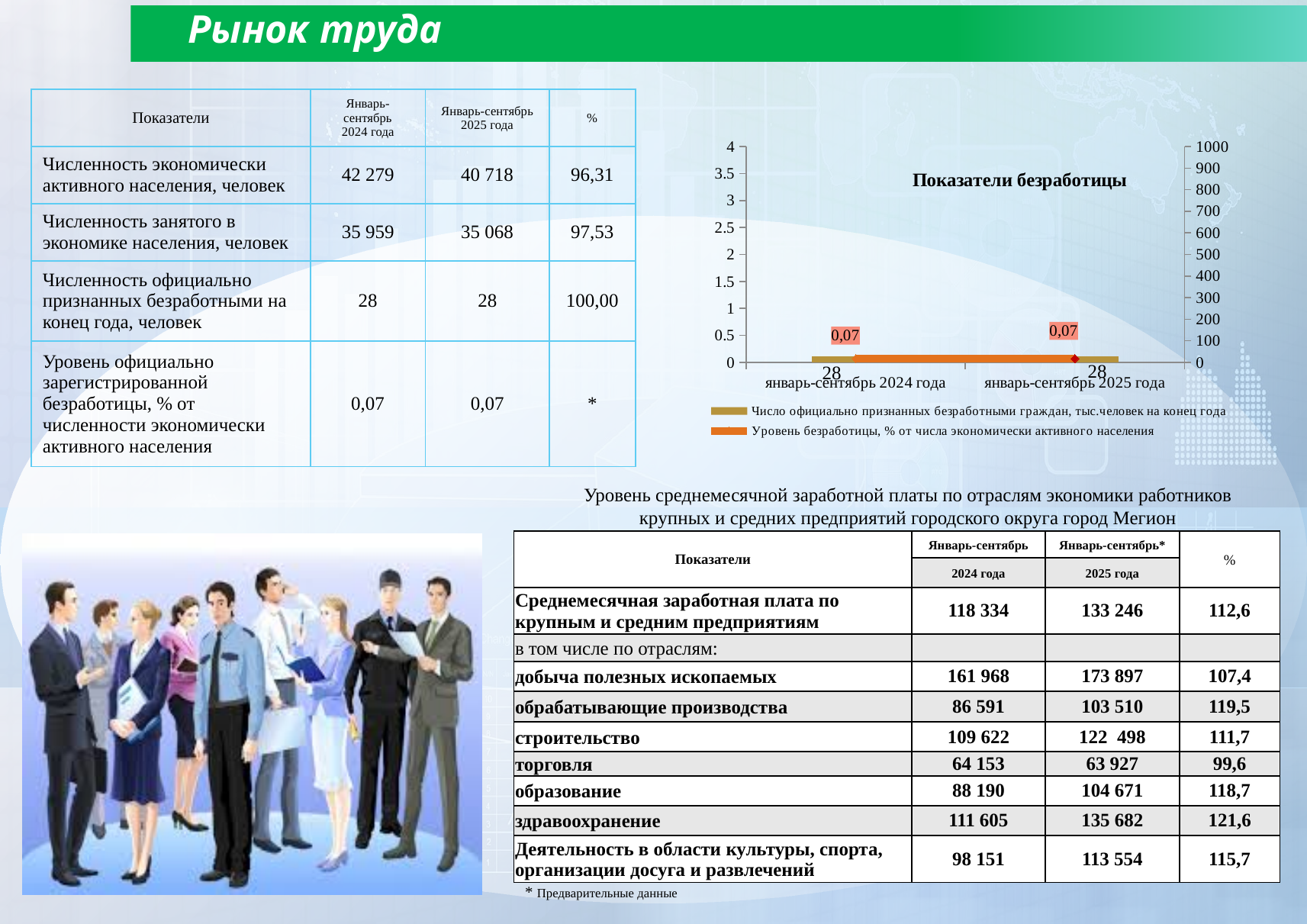
In the chart "Показатели безработицы", is the unemployment rate for январь-сентябрь 2025 года greater or less than 0.5? less In the chart "Показатели безработицы", what is the unemployment rate (% of economically active population) for январь-сентябрь 2025 года? 0,07 In the chart "Показатели безработицы", what is the number of officially recognized unemployed citizens (тыс. человек) for январь-сентябрь 2024 года? 28 What is the title of the chart on the slide? Показатели безработицы What kind of chart is "Показатели безработицы"? Combined bar and line chart In the chart "Показатели безработицы", which series is shown in orange according to the legend? Уровень безработицы, % от числа экономически активного населения In the chart "Показатели безработицы", does the unemployment rate rise, fall or stay the same from январь-сентябрь 2024 года to январь-сентябрь 2025 года? Stays the same In the chart "Показатели безработицы", what is the unemployment rate (% of economically active population) for январь-сентябрь 2024 года? 0,07 In the chart "Показатели безработицы", what is the number of officially recognized unemployed citizens (тыс. человек) for январь-сентябрь 2025 года? 28 How many series does the legend of the chart "Показатели безработицы" list? 2 How many periods (categories) are shown on the x axis of the chart "Показатели безработицы"? 2 In the chart "Показатели безработицы", what is the difference between the number of officially recognized unemployed in январь-сентябрь 2025 года and январь-сентябрь 2024 года? 0